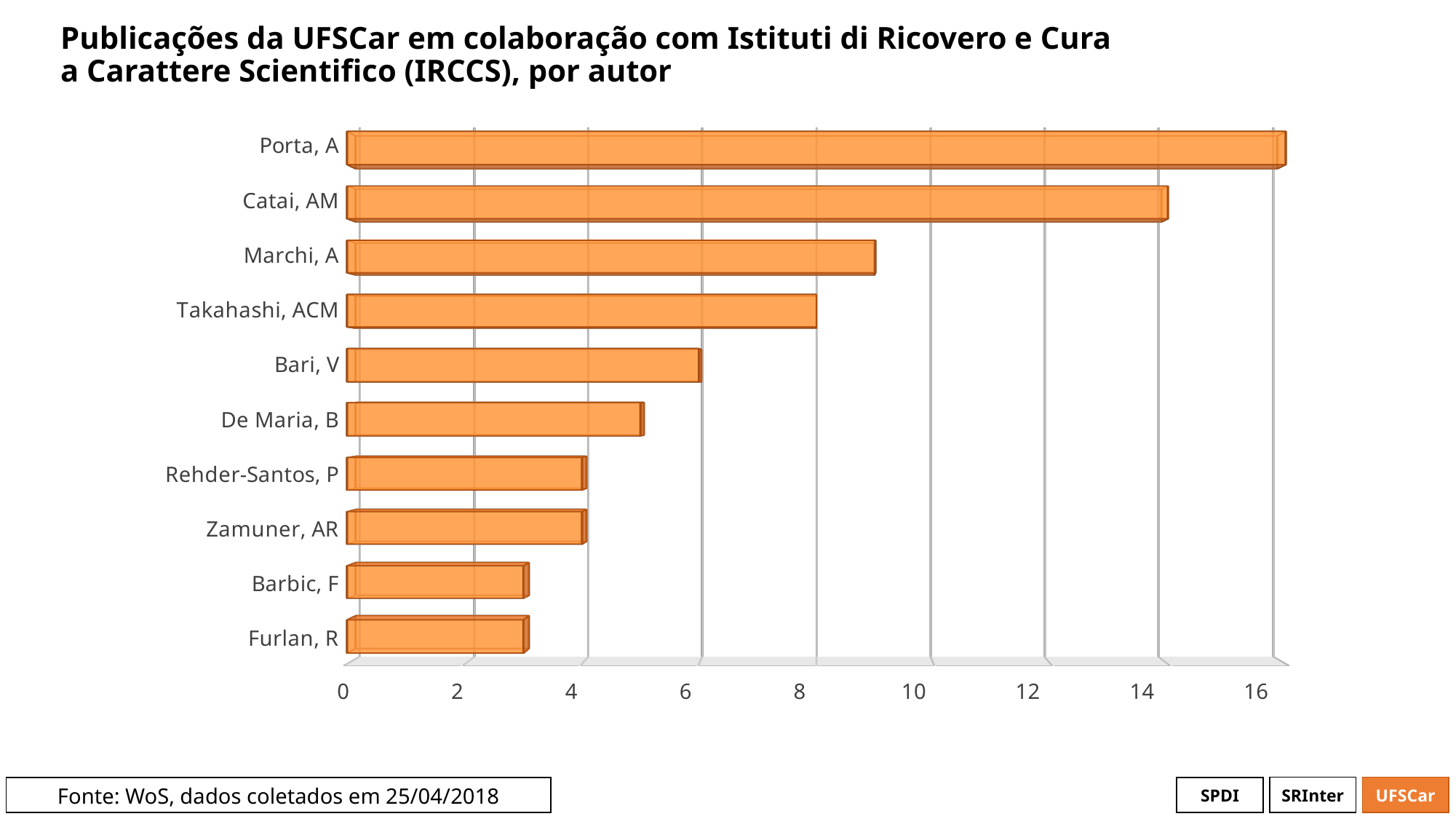
What is the value for Catai, AM? 14 What type of chart is shown on the slide? bar chart Which is larger, the value for Marchi, A or the value for Takahashi, ACM? Marchi, A What is the difference between the values for Porta, A and Catai, AM? 2 What is the value for Takahashi, ACM? 8 What is the data source cited at the bottom of the slide? WoS, dados coletados em 25/04/2018 How many authors are shown in the chart? 10 Is the value for Barbic, F greater or less than 4? less What is the value for Porta, A? 16 Which author has the highest number of publications? Porta, A What is the value for Bari, V? 6 Is the value for Marchi, A greater or less than 8? greater